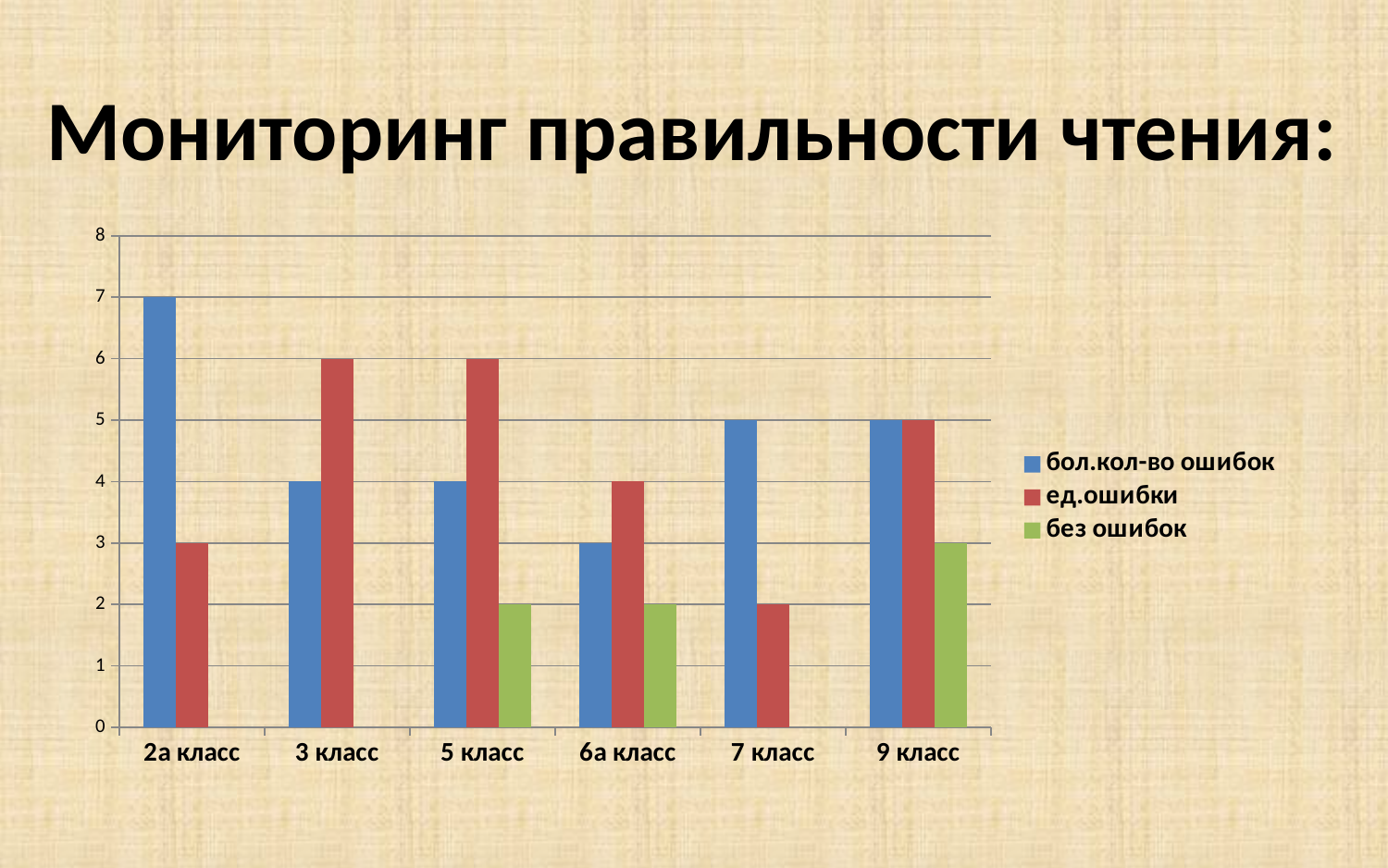
How many classes are shown on the x axis? 6 How many series does the legend list? 3 Which class has the highest value for 'бол.кол-во ошибок'? 2а класс What is the value of 'ед.ошибки' for 3 класс? 6 For 5 класс, which is larger: 'бол.кол-во ошибок' or 'ед.ошибки'? ед.ошибки What is the value of 'бол.кол-во ошибок' for 2а класс? 7 Which class has the lowest value for 'ед.ошибки'? 7 класс What is the difference between 'бол.кол-во ошибок' and 'ед.ошибки' for 2а класс? 4 What kind of chart is shown on the slide? bar chart Is the value of 'бол.кол-во ошибок' for 7 класс greater or less than 4? greater What is the value of 'без ошибок' for 9 класс? 3 What is the title of the slide? Мониторинг правильности чтения: